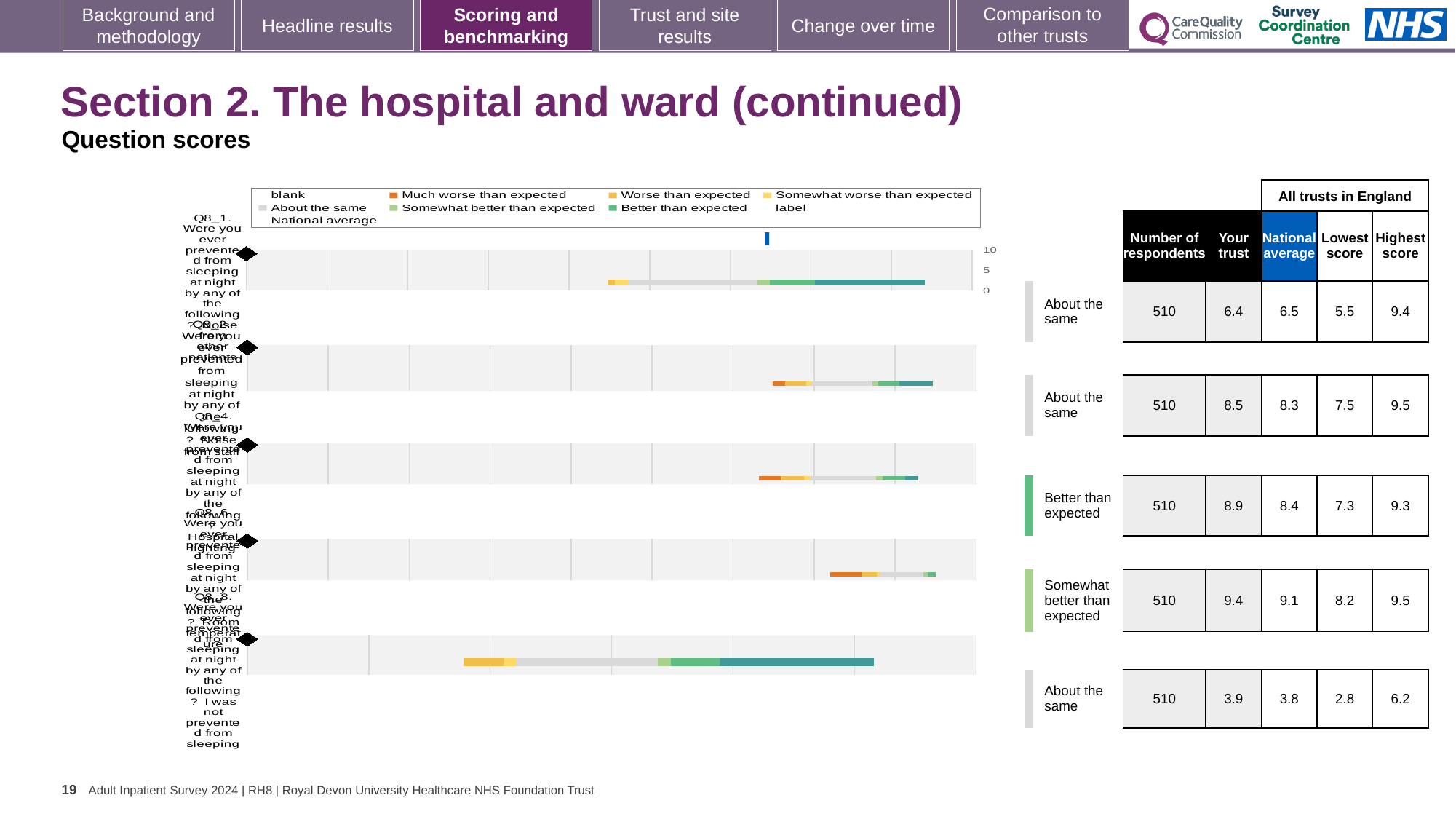
Which row has the highest 'Your trust' score in the table beside the chart? the fourth row (Q8_6), 9.4 How many respondents are listed for each question row in the table? 510 What is the highest score among all trusts in England for the fifth row (Q8_8)? 6.2 For the second row (Q8_2), which is larger: the 'Your trust' score or the national average? Your trust (8.5) Which row has the lowest 'Your trust' score in the table beside the chart? the fifth row (Q8_8), 3.9 For the fourth row (Q8_6), what is the difference between the 'Your trust' score and the national average? 0.3 In the table beside the chart, what is the national average for the third row (Q8_4)? 8.4 What kind of chart is shown on the slide? bar chart How many question rows (bars) are plotted in the chart? 5 What is the lowest score among all trusts in England for the first row (Q8_1)? 5.5 In the table beside the chart, what is the 'Your trust' score for the first row (Q8_1)? 6.4 What benchmark label is given to the third row (Q8_4)? Better than expected